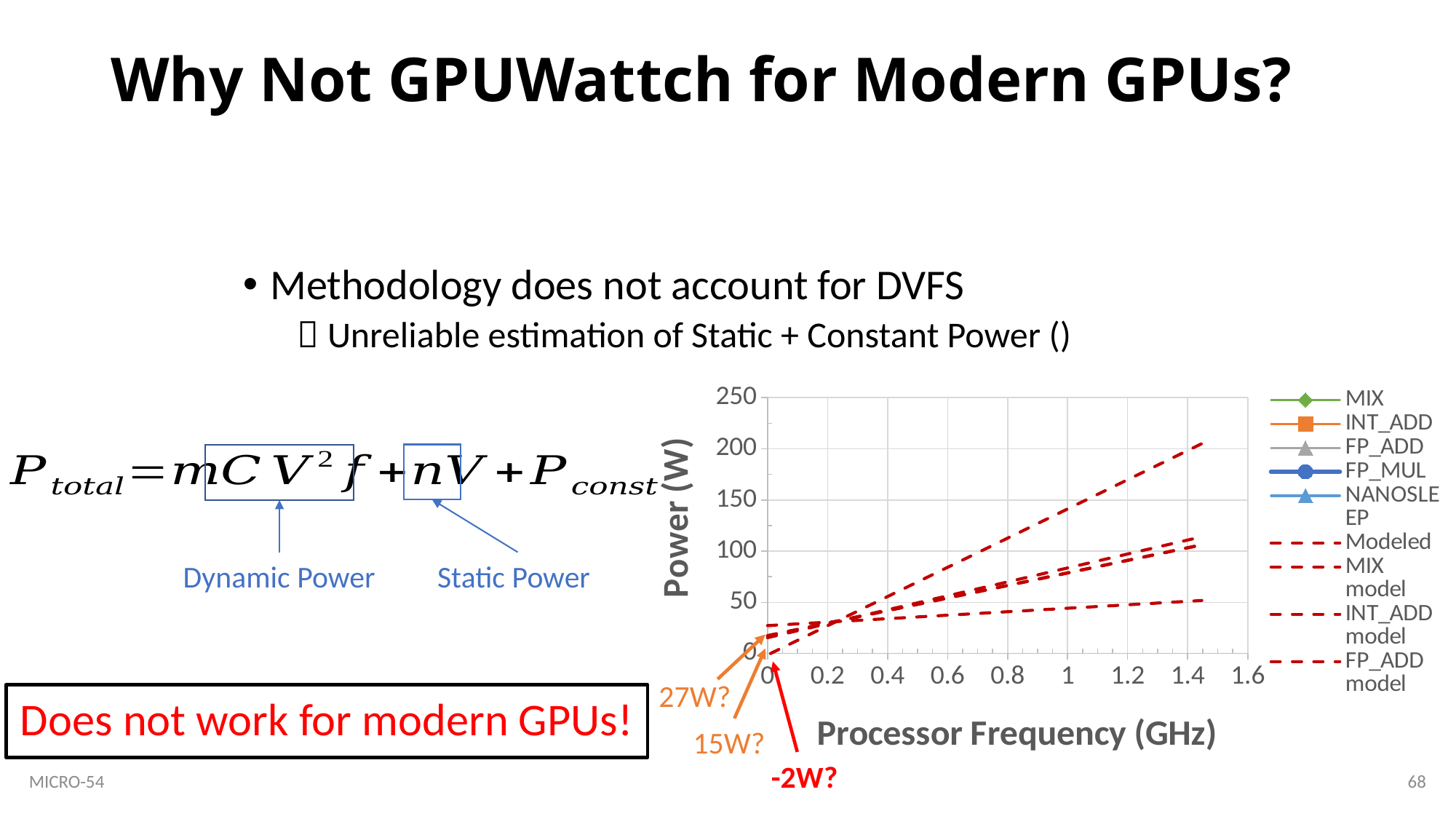
Which annotated intercept value near the origin of the chart is negative? -2W? What is the highest value shown on the y axis of the chart? 250 Which annotated intercept value near the origin of the chart is the largest? 27W? What is the title of the y axis of the chart? Power (W) What is the highest value shown on the x axis of the chart? 1.6 Is the value of the steepest dashed line at 0.6 GHz greater or less than 50? greater Do the dashed model lines rise or fall as processor frequency increases? rise How many series does the chart's legend list? 9 Is the value of the flattest dashed line at 1.4 GHz greater or less than 100? less Is the value of the steepest dashed line at 1.4 GHz greater or less than 150? greater What is the title of the x axis of the chart? Processor Frequency (GHz) What kind of chart is shown on the slide? line chart